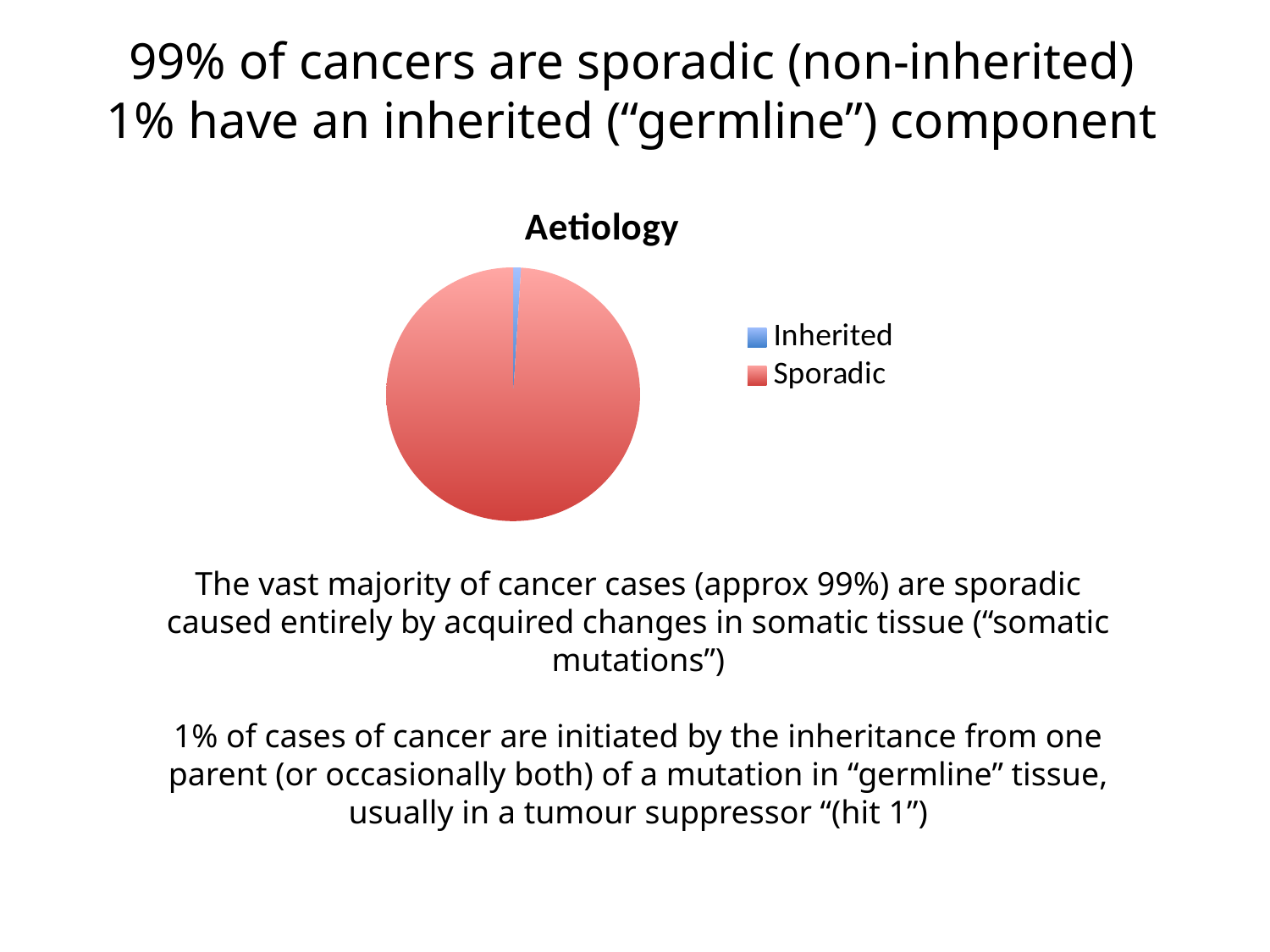
Which category has the smallest slice of the pie? Inherited Which category is shown in blue in the legend? Inherited How many slices does the pie chart have? 2 Which category has the largest slice of the pie? Sporadic What colour is the Sporadic slice in the pie chart? red What kind of chart is shown under the title "Aetiology"? pie chart How many entries does the chart legend list? 2 What is the title of the chart? Aetiology Which slice is larger, Inherited or Sporadic? Sporadic